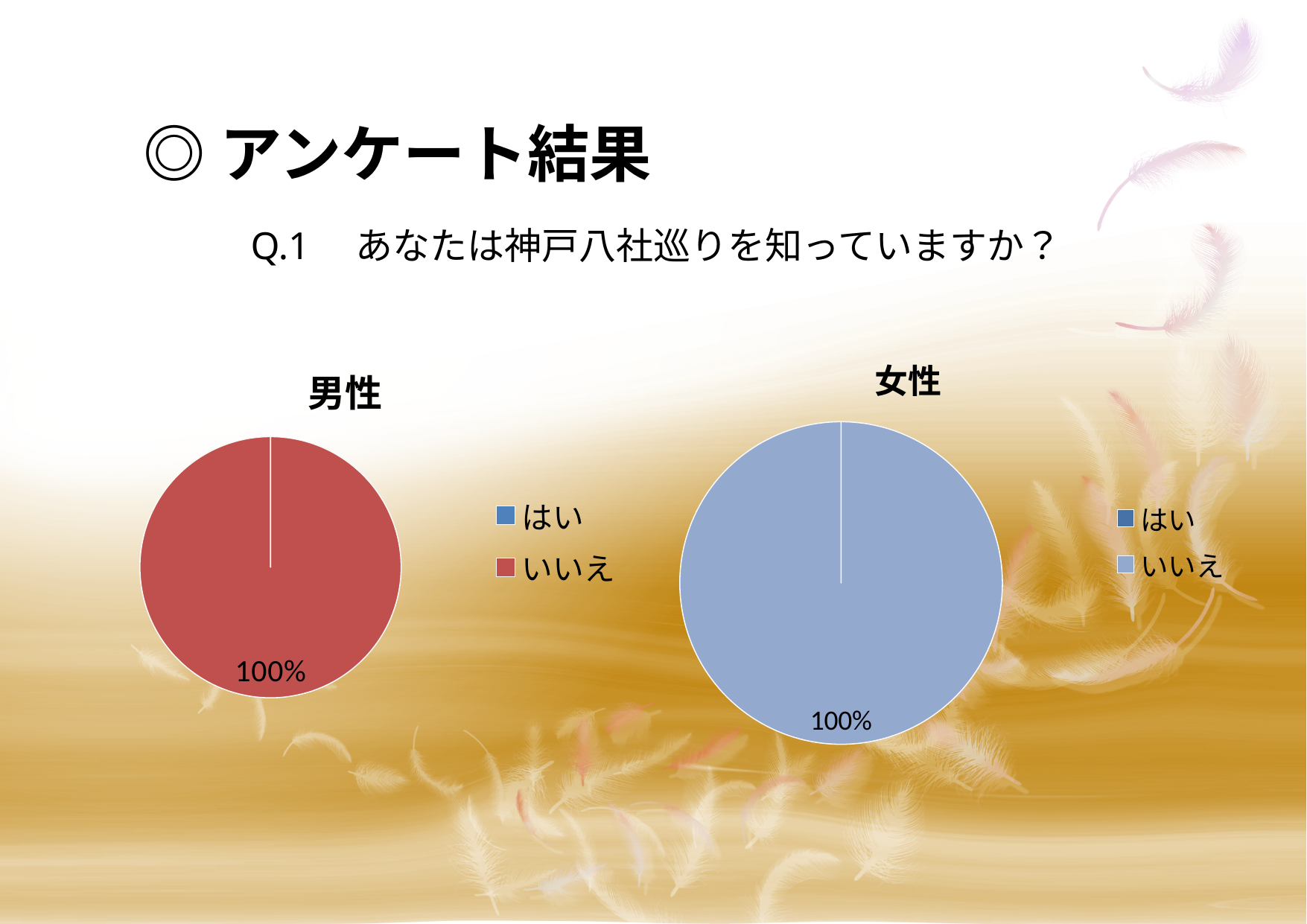
What kind of chart is the 女性 chart? pie chart In the 男性 chart, which category makes up the whole pie? いいえ In the 女性 chart, what share of the pie is いいえ? 100% How many entries does the legend of the 男性 chart list? 2 What is the title of the chart on the left? 男性 What kind of chart is the 男性 chart? pie chart How many entries does the legend of the 女性 chart list? 2 In the 男性 chart, what colour represents いいえ? red How many pie charts are shown on the slide? 2 In the 男性 chart, what share of the pie is いいえ? 100% In the 女性 chart, what colour represents いいえ? light blue In the 女性 chart, which category makes up the whole pie? いいえ